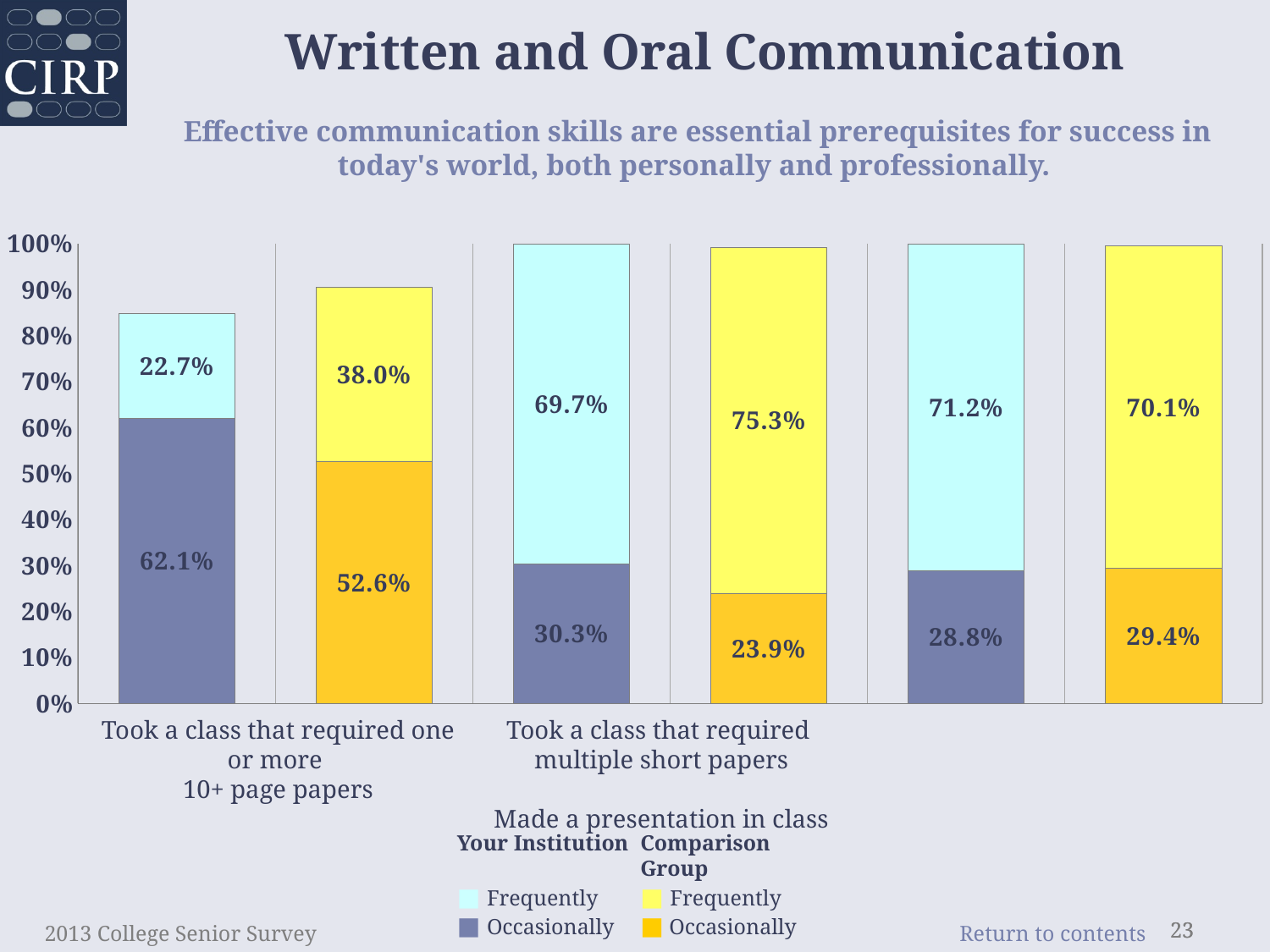
Which is larger: the 'Frequently' value for Your Institution or for the Comparison Group for taking a class that required multiple short papers? Comparison Group What percentage of the Comparison Group occasionally took a class that required one or more 10+ page papers? 52.6% Across all bars, which segment has the highest 'Frequently' value? Comparison Group, Took a class that required multiple short papers (75.3%) What percentage of students at Your Institution frequently made a presentation in class? 71.2% What is the difference between the Comparison Group's 'Frequently' value and Your Institution's 'Frequently' value for taking a class that required one or more 10+ page papers? 15.3% How many activity categories are shown along the x axis? 3 What kind of chart is shown on the slide? Stacked bar chart What is the total of the Comparison Group stacked bar for 'Took a class that required one or more 10+ page papers'? 90.6% What percentage of students at Your Institution frequently took a class that required one or more 10+ page papers? 22.7% What is the total of the Your Institution stacked bar for 'Took a class that required one or more 10+ page papers'? 84.8% What percentage of the Comparison Group occasionally took a class that required multiple short papers? 23.9% How many entries does the legend list? 4